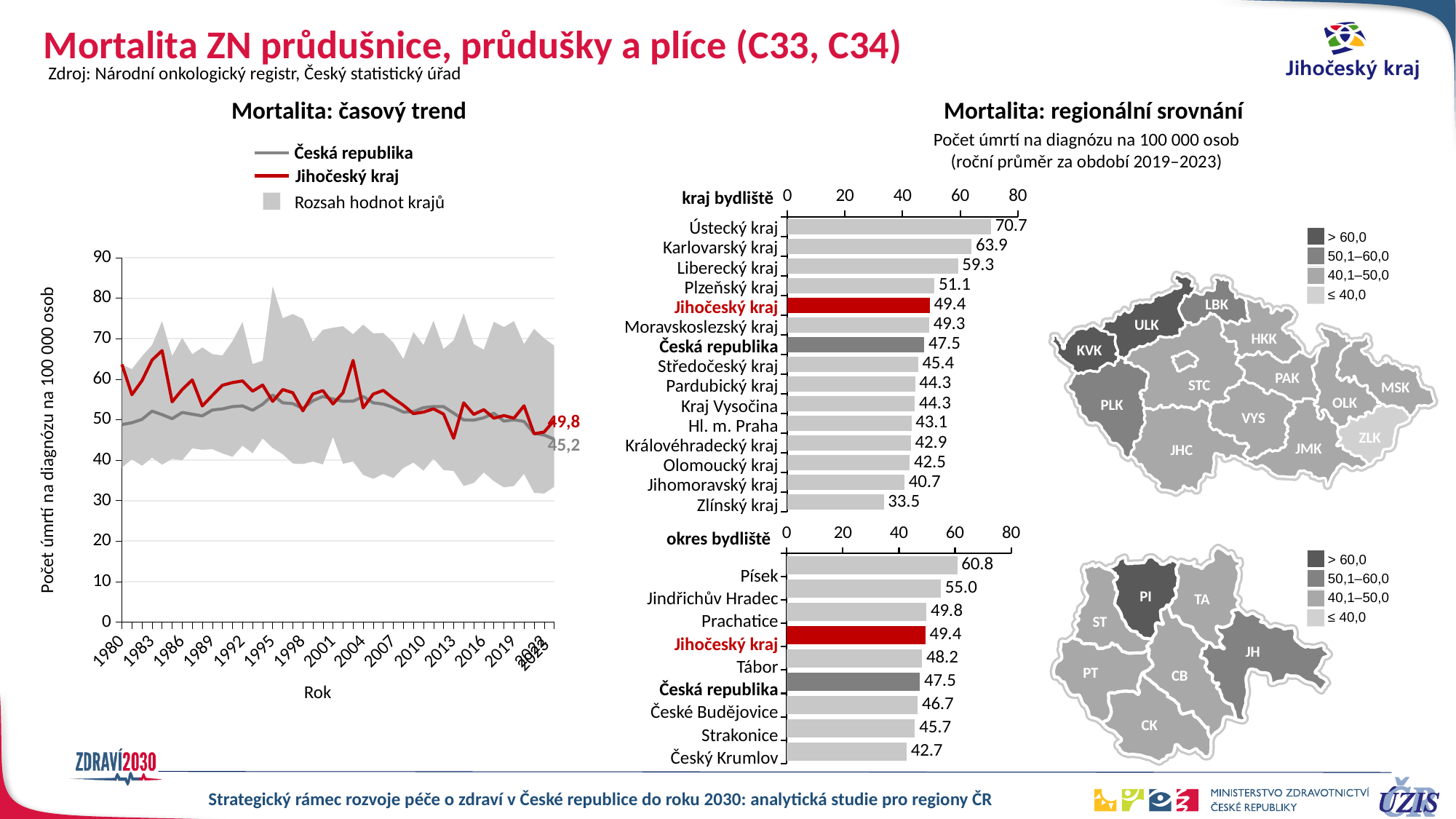
In the bar chart by kraj bydliště, what is the difference between Ústecký kraj and Zlínský kraj? 37.2 In the bar chart by okres bydliště, how many districts (excluding Jihočeský kraj and Česká republika) are shown? 7 In the 'Mortalita: regionální srovnání' bar chart by kraj bydliště, what is the value for Ústecký kraj? 70.7 In the bar chart by kraj bydliště, which is larger: Plzeňský kraj or Česká republika? Plzeňský kraj In the bar chart by kraj bydliště, which region has the lowest value? Zlínský kraj In the bar chart by okres bydliště, what is the value for Český Krumlov? 42.7 In the bar chart by kraj bydliště, what is the value for Jihočeský kraj? 49.4 In the bar chart by okres bydliště, what is the value for Jindřichův Hradec? 55.0 In the bar chart by okres bydliště, which district has the highest value? Písek In the 'Mortalita: časový trend' chart, what is the final labelled value for Jihočeský kraj? 49,8 What type of chart is 'Mortalita: časový trend'? Combination line and area chart (lines with a shaded range band) In the 'Mortalita: časový trend' chart, what is the final labelled value for Česká republika? 45,2